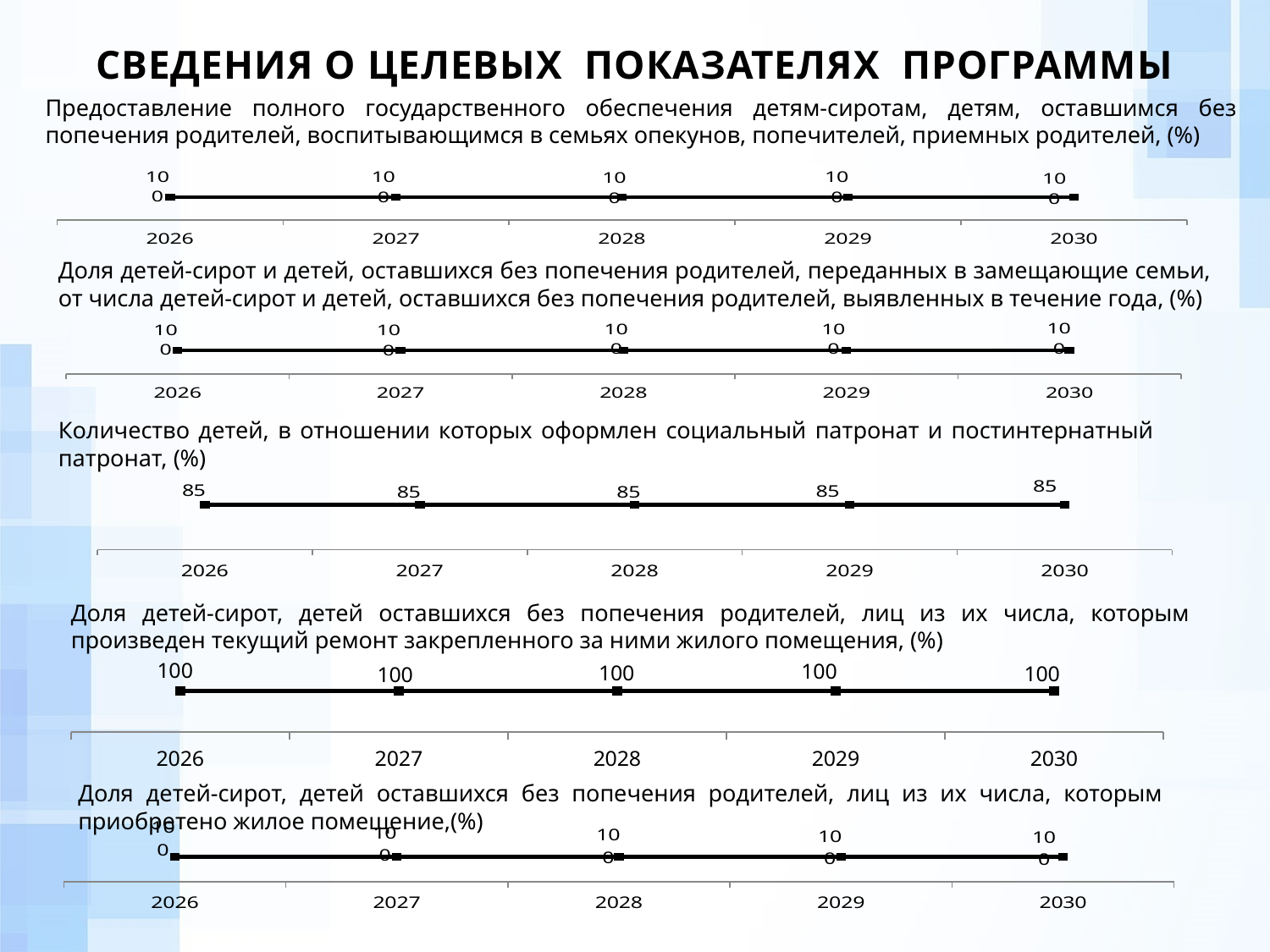
What kind of chart is the third chart (социальный патронат и постинтернатный патронат)? line chart In the fourth chart (произведен текущий ремонт закрепленного за ними жилого помещения), what is the value for 2028? 100 How many charts are shown on the slide? 5 In the third chart (Количество детей, в отношении которых оформлен социальный патронат и постинтернатный патронат), what is the value for 2026? 85 In the fourth chart (произведен текущий ремонт), what is the difference between the values for 2026 and 2030? 0 In the third chart (социальный патронат и постинтернатный патронат), do the values rise, fall or stay the same from 2026 to 2030? stay the same In the third chart (социальный патронат и постинтернатный патронат), is the value for 2027 larger than, smaller than or equal to the value for 2029? equal In the fourth chart (произведен текущий ремонт закрепленного за ними жилого помещения), what is the value for 2030? 100 In the fourth chart (произведен текущий ремонт), do the values rise, fall or stay the same across the years? stay the same How many data points are plotted in the fourth chart (произведен текущий ремонт)? 5 In the third chart (социальный патронат и постинтернатный патронат), what is the value for 2030? 85 What is the first year shown on the x axis of the third chart (социальный патронат и постинтернатный патронат)? 2026